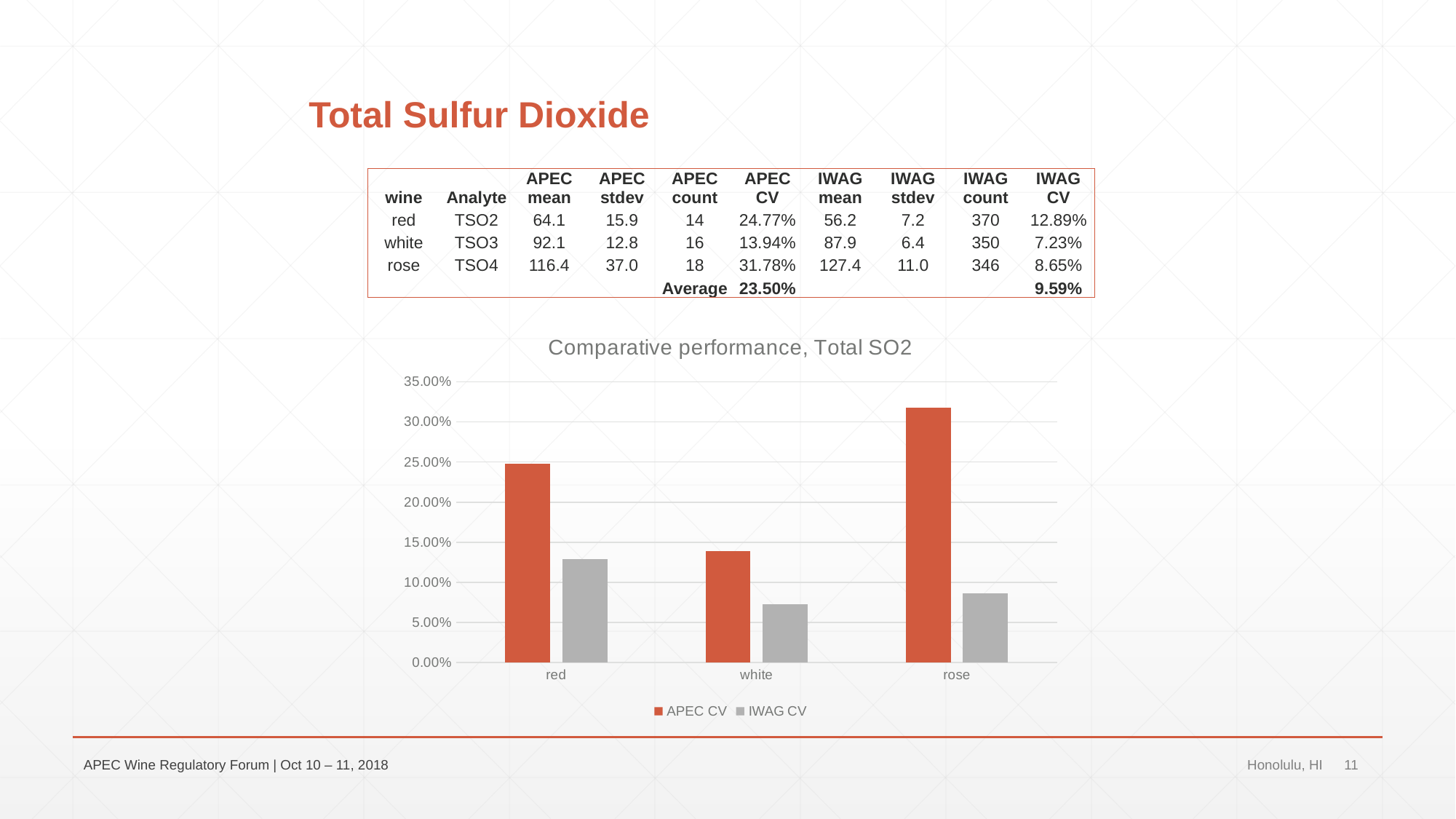
How many series does the legend of the "Comparative performance, Total SO2" chart list? 2 In the "Comparative performance, Total SO2" chart, which is larger for white: the APEC CV bar or the IWAG CV bar? APEC CV What colour are the APEC CV bars in the "Comparative performance, Total SO2" chart? orange According to the table on the slide, what is the IWAG CV value for red plotted in the chart? 12.89% In the "Comparative performance, Total SO2" chart, is the APEC CV bar for red greater or less than 20.00%? greater Which wine category has the highest APEC CV bar in the "Comparative performance, Total SO2" chart? rose How many wine categories are shown on the x axis of the "Comparative performance, Total SO2" chart? 3 In the "Comparative performance, Total SO2" chart, is the IWAG CV bar for white greater or less than 10.00%? less In the "Comparative performance, Total SO2" chart, is the APEC CV bar for rose greater or less than 30.00%? greater Which wine category has the lowest IWAG CV bar in the "Comparative performance, Total SO2" chart? white According to the table on the slide, what is the APEC CV value for rose plotted in the chart? 31.78% What kind of chart is shown under the title "Comparative performance, Total SO2"? bar chart